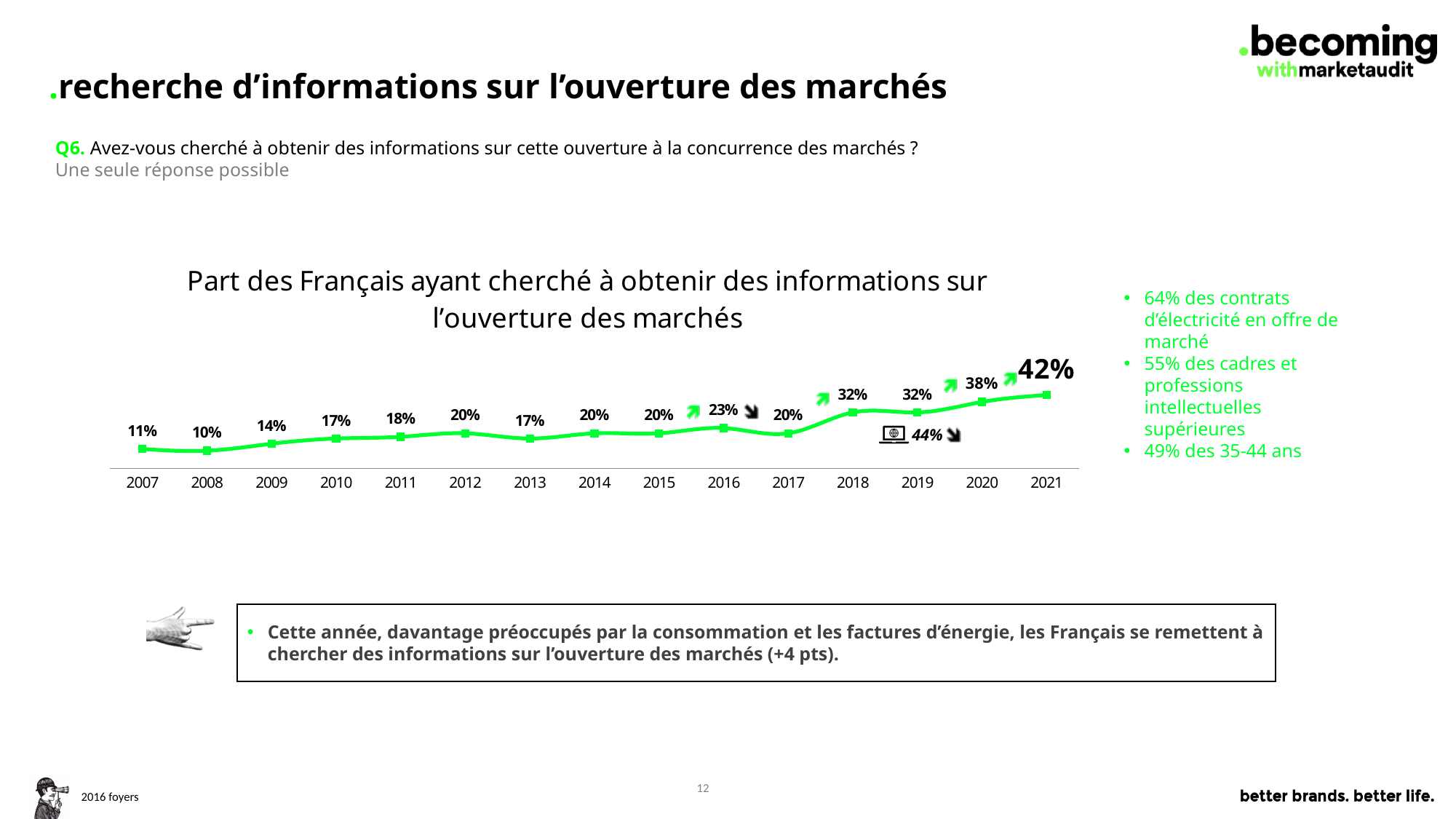
How many years are plotted on the x axis? 15 What is the value for 2016? 23% Do the values generally rise or fall from 2007 to 2021? Rise Which year has the highest value? 2021 What is the value for 2021? 42% What is the difference between the values for 2018 and 2017? 12 points What kind of chart is this? Line chart Which is larger, the value for 2013 or the value for 2012? 2012 What is the value for 2020? 38% What is the value for 2007? 11% Which year has the lowest value? 2008 What is the difference between the values for 2021 and 2020? 4 points